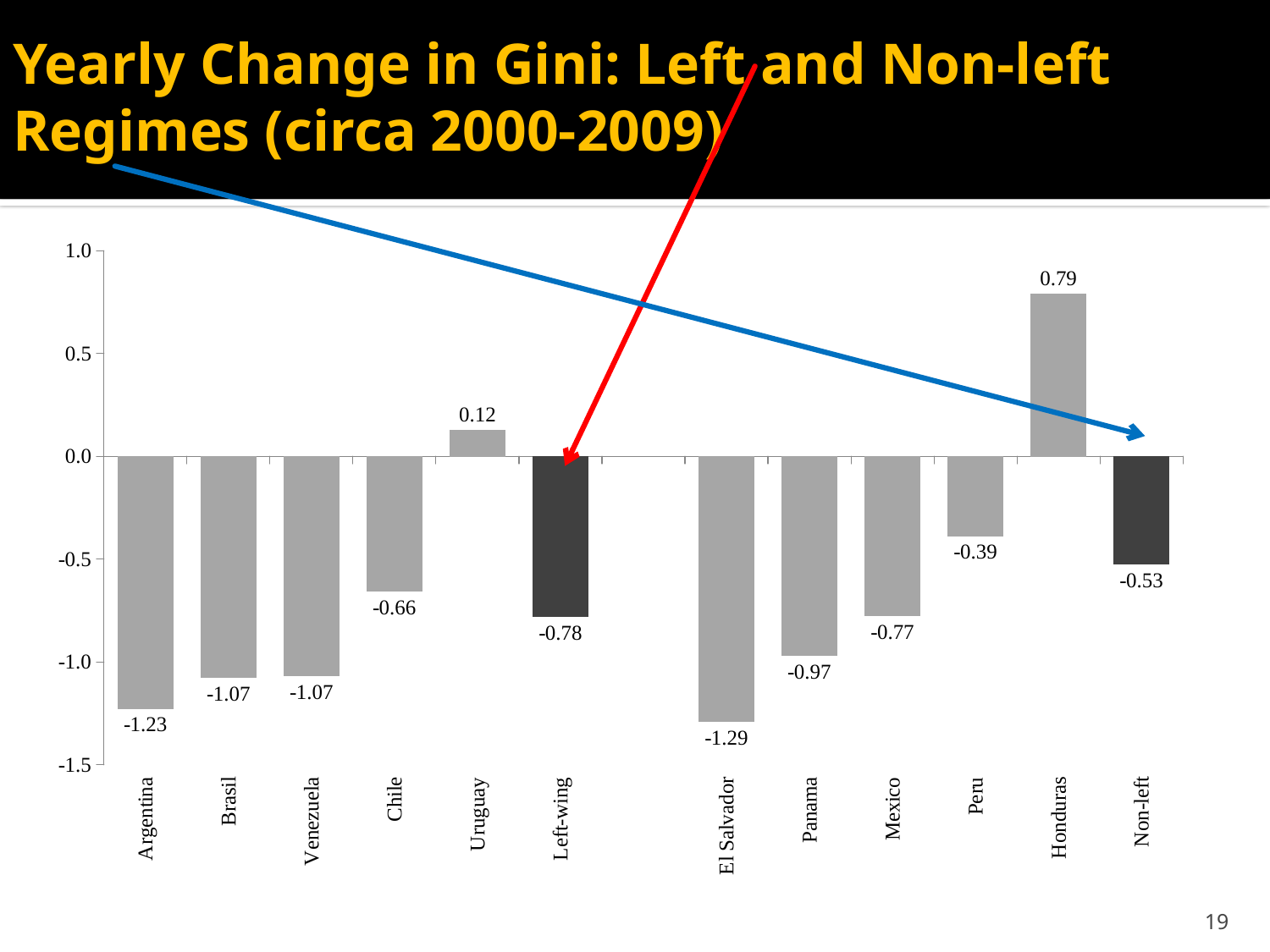
How many categories are shown on the x axis? 12 Which has a larger value, Uruguay or Chile? Uruguay Which category has the highest value? Honduras What is the value shown for Honduras? 0.79 What is the value shown for the Left-wing bar? -0.78 What is the title of the slide? Yearly Change in Gini: Left and Non-left Regimes (circa 2000-2009) What is the difference between the Left-wing value and the Non-left value? 0.25 What is the value shown for the Non-left bar? -0.53 Which category has the lowest value? El Salvador What kind of chart is shown on the slide? Bar chart What is the yearly change in Gini for Argentina? -1.23 Is the value for Peru greater or less than -0.5? greater